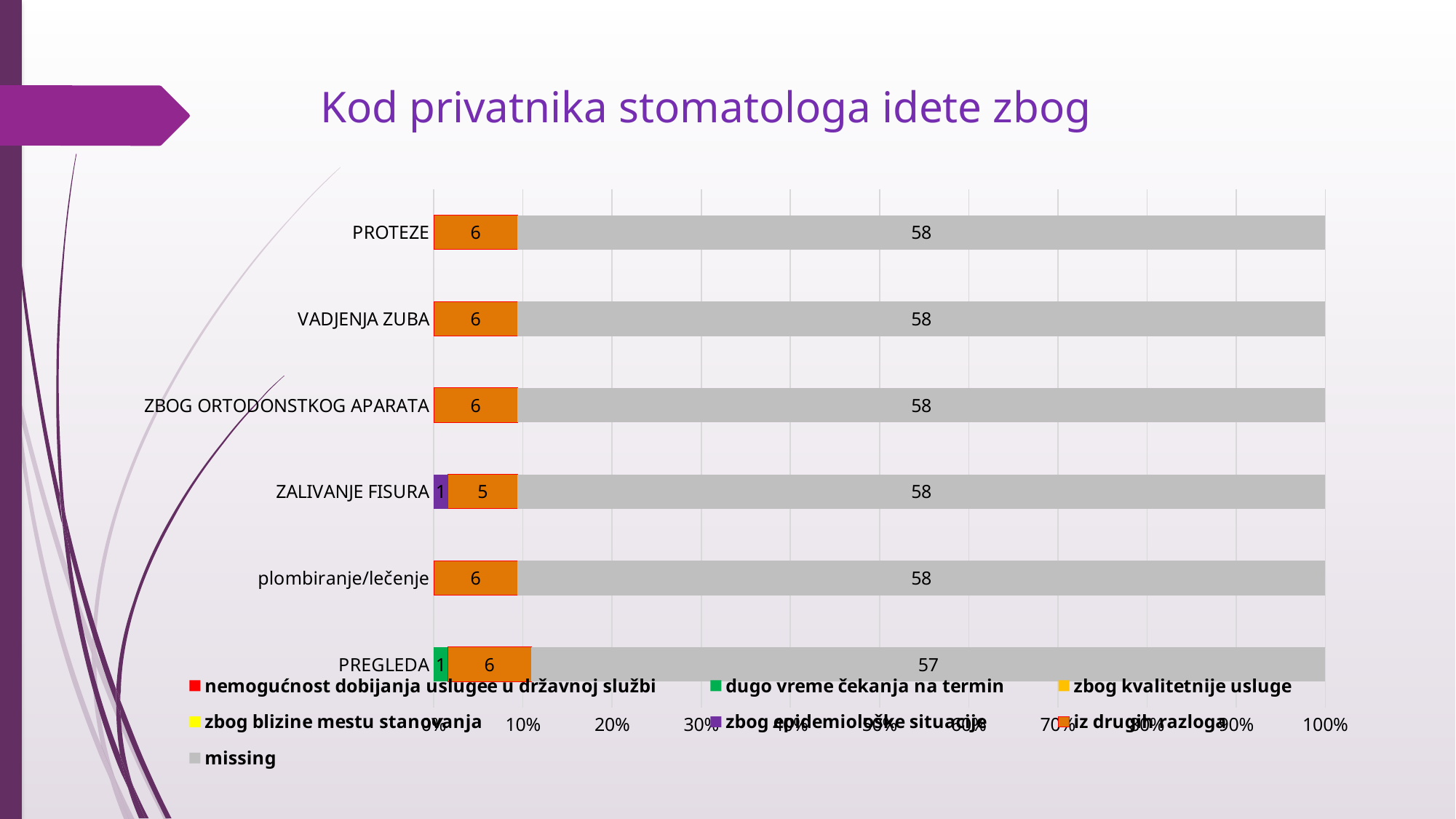
What is the total of the stacked bar for PREGLEDA? 64 How many series does the legend list? 7 Which category has the lowest 'missing' value? PREGLEDA What is the 'iz drugih razloga' value for ZALIVANJE FISURA? 5 What is the 'dugo vreme čekanja na termin' value for PREGLEDA? 1 What is the difference between the 'missing' value for PROTEZE and the 'missing' value for PREGLEDA? 1 What is the 'missing' value for PROTEZE? 58 How many categories are shown on the vertical axis of the chart? 6 What is the 'zbog epidemiološke situacije' value for ZALIVANJE FISURA? 1 What type of chart is shown on the slide? stacked bar chart What is the 'missing' value for PREGLEDA? 57 What is the title of the slide? Kod privatnika stomatologa idete zbog